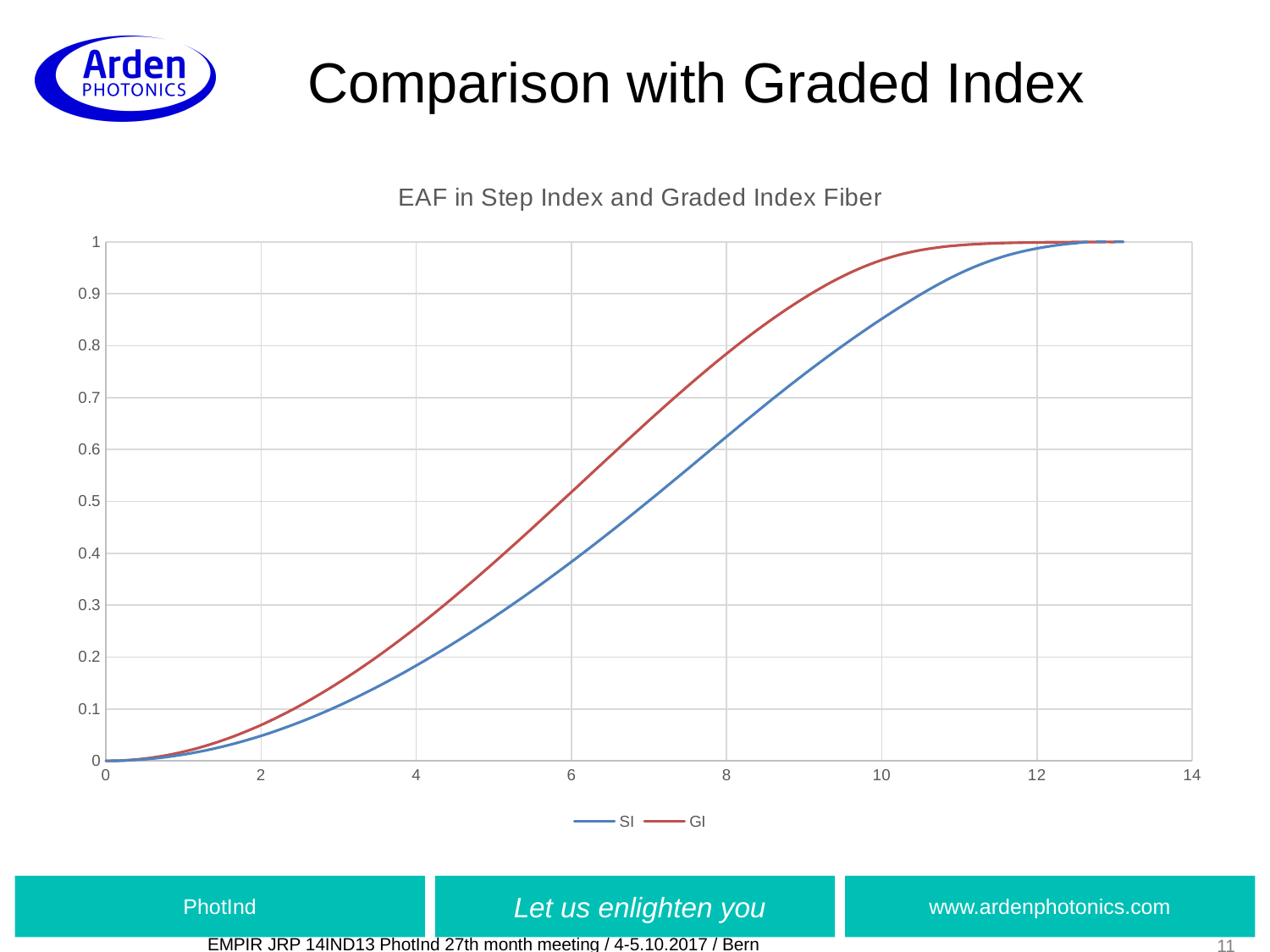
Is the value of GI at x = 10 greater or less than 0.9? greater What is the title of the chart? EAF in Step Index and Graded Index Fiber At x = 8, which series has the lower value, SI or GI? SI Which colour is used for the GI series? red How many series does the legend list? 2 Do the SI and GI curves rise or fall as x increases? rise Is the value of SI at x = 8 greater or less than 0.5? greater At x = 6, which series has the higher value, SI or GI? GI Is the value of SI at x = 2 greater or less than 0.1? less What kind of chart is shown on the slide? line chart